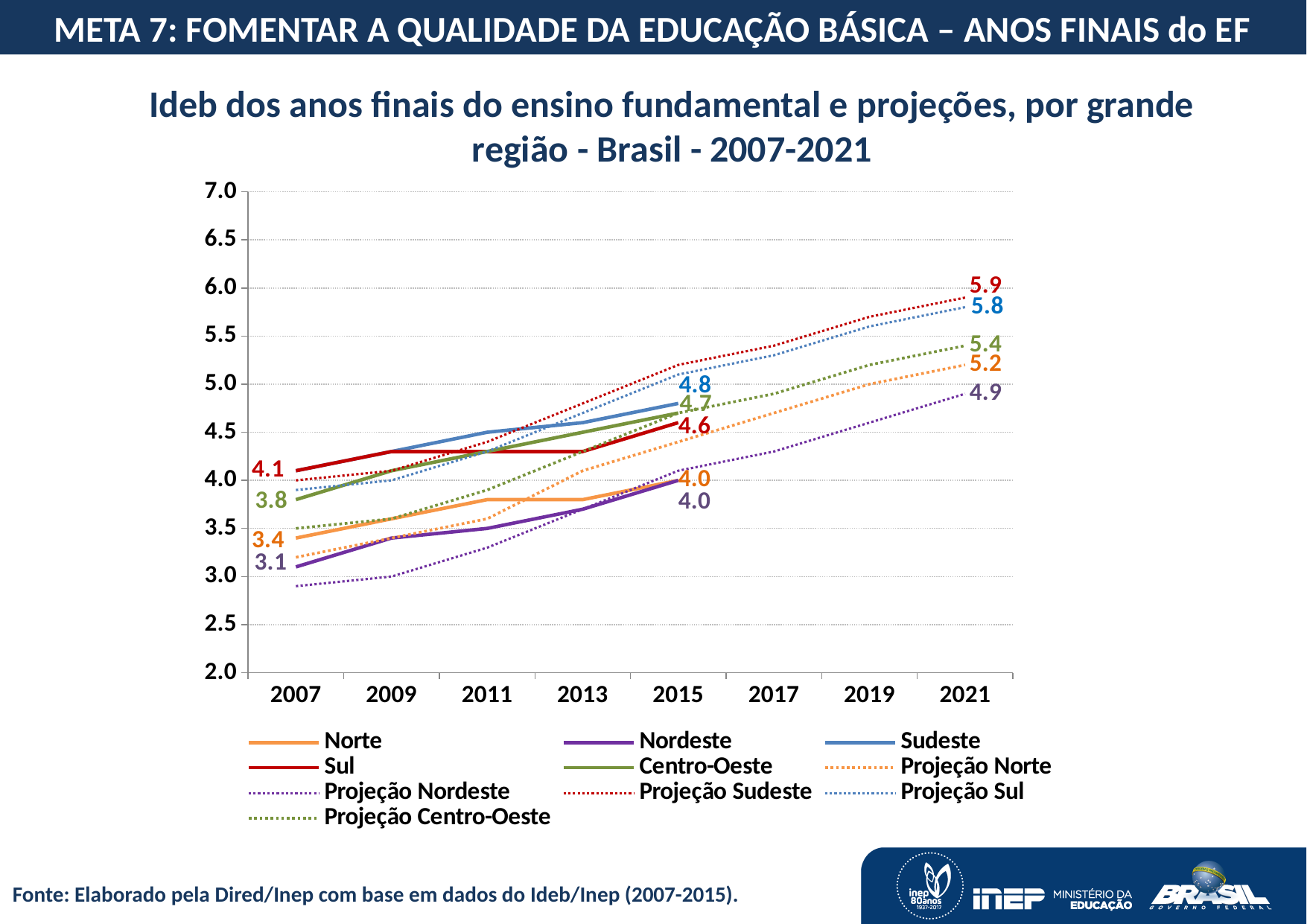
What is the projected value for Projeção Centro-Oeste in 2021? 5.4 What kind of chart is shown on the slide? line chart By how much did the Ideb value for Sul increase from 2007 (4.1) to 2015 (4.6)? 0.5 How many series does the legend list? 10 Is the value for Nordeste in 2011 greater or less than 4.0? less Which region has the lowest labelled Ideb value in 2007? Nordeste What is the Ideb value for Sudeste in 2015? 4.8 What is the Ideb value for Nordeste in 2007? 3.1 What is the Ideb value for Sul in 2007? 4.1 Which projection series has the highest value in 2021? Projeção Sudeste What is the projected value for Projeção Nordeste in 2021? 4.9 Does the Norte line rise or fall from 2007 to 2015? rise